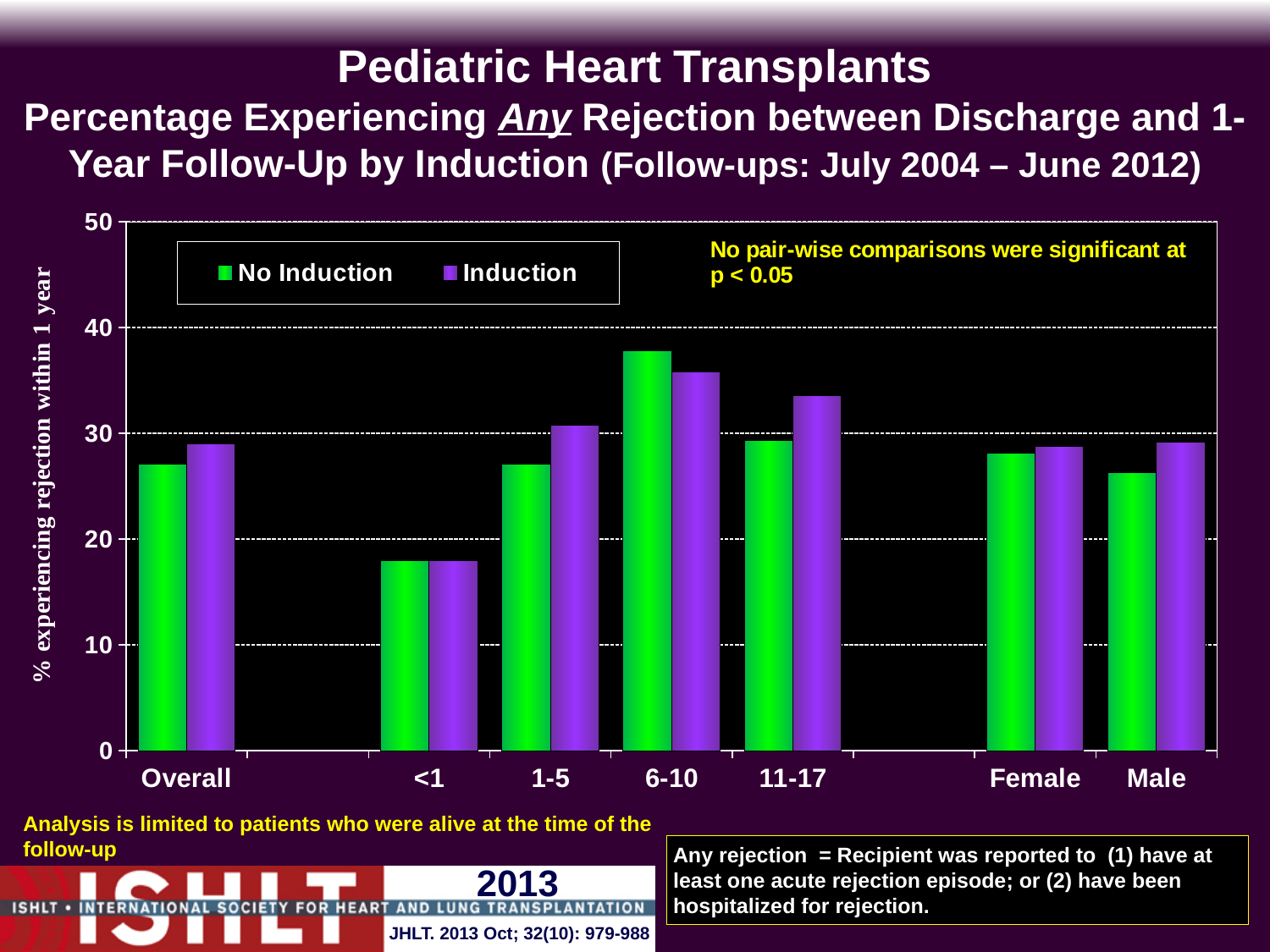
Which category has the highest No Induction value? 6-10 How many categories are shown along the x axis? 7 Which colour represents the Induction series in the legend? purple Which category has the highest Induction value? 6-10 Is the No Induction value for 6-10 greater or less than 30? greater What kind of chart is shown on the slide? bar chart Which category has the lowest No Induction value? <1 Is the No Induction value for <1 greater or less than 20? less How many series does the legend list? 2 Is the Induction value for 11-17 greater or less than 30? greater For the 1-5 age group, which is larger: the No Induction value or the Induction value? Induction Which category has the lowest Induction value? <1